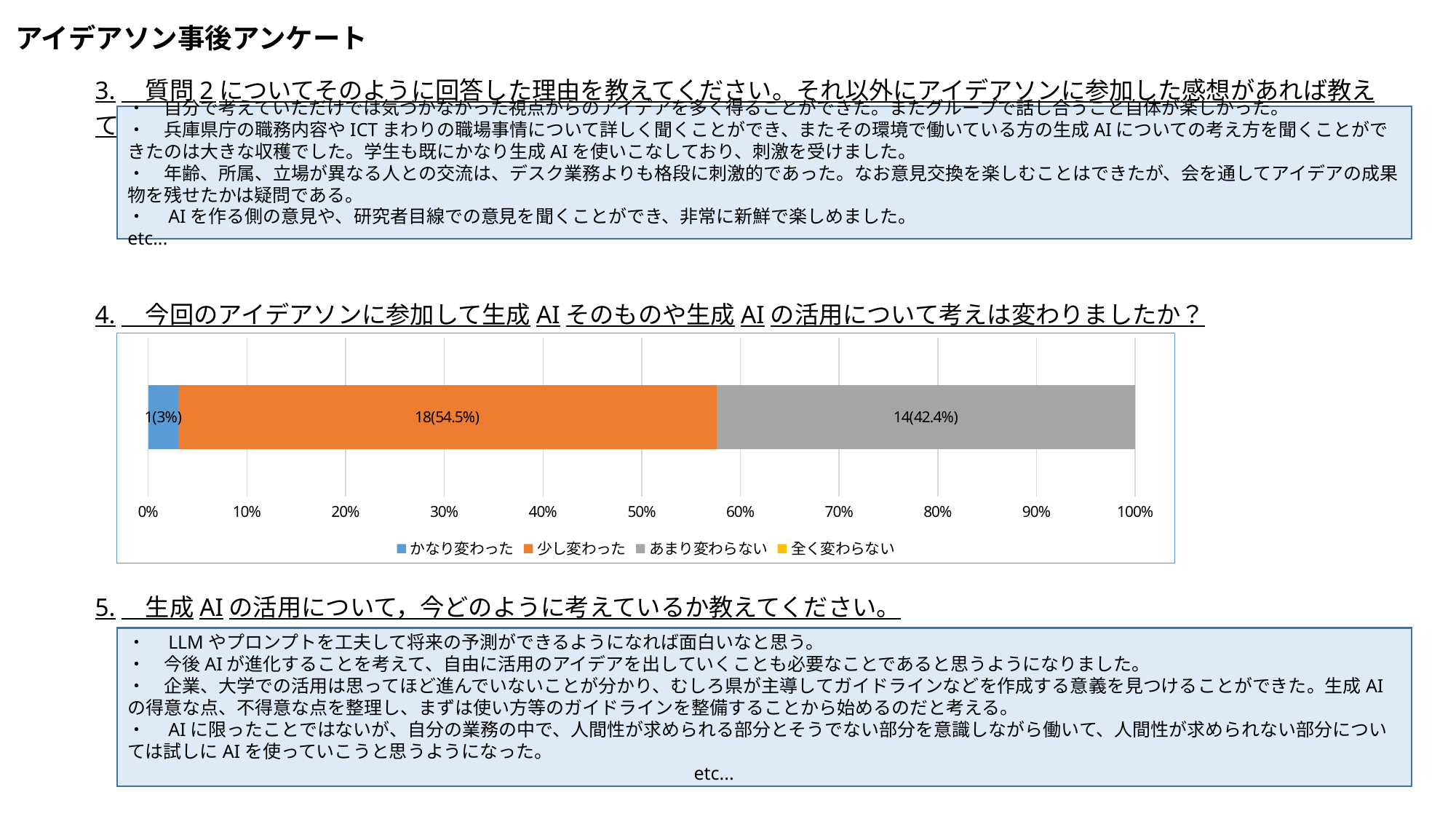
Which is larger in the chart, 少し変わった or あまり変わらない? 少し変わった What colour is the segment for あまり変わらない in the chart? gray What is the data label for 少し変わった in the chart? 18(54.5%) How many more respondents chose 少し変わった than あまり変わらない? 4 Is the share for 少し変わった greater or less than 50%? greater What is the total number of respondents shown by the labelled segments of the bar? 33 What is the data label for かなり変わった in the chart? 1(3%) What kind of chart is shown under question 4? stacked bar chart Which of the labelled segments in the chart is the smallest? かなり変わった Which response category has the largest segment in the chart? 少し変わった What is the data label for あまり変わらない in the chart? 14(42.4%) How many series does the legend of the chart list? 4